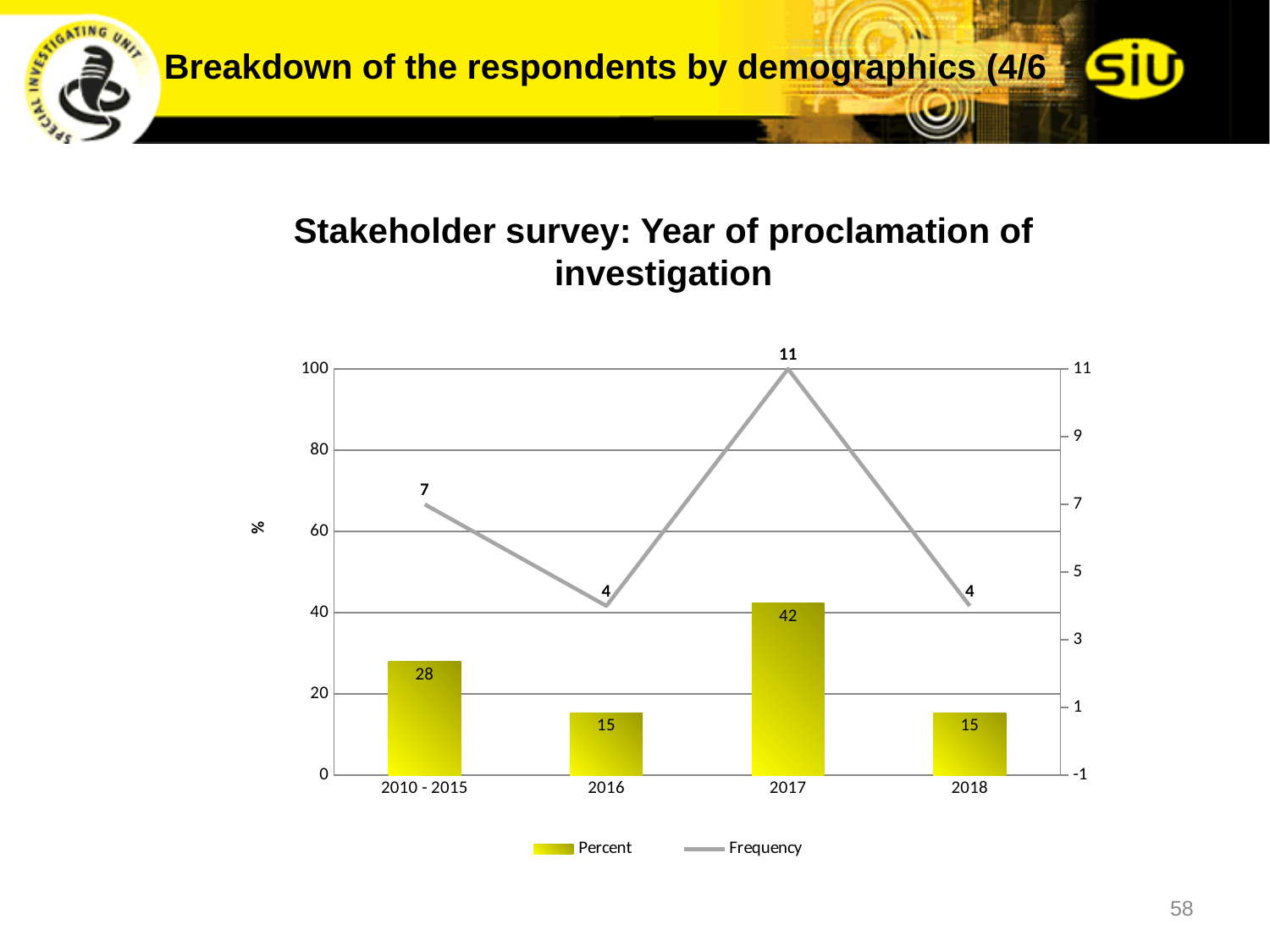
What is the difference between the Percent values for 2017 and 2010 - 2015? 14 What is the difference between the Frequency values for 2017 and 2018? 7 Which is larger, the Percent value for 2010 - 2015 or for 2018? 2010 - 2015 What is the Percent value for 2017? 42 How many series does the legend list? 2 What is the Frequency value for 2010 - 2015? 7 Which category has the highest Frequency? 2017 How many categories are shown on the x axis? 4 What is the Percent value for 2016? 15 What is the title of the chart? Stakeholder survey: Year of proclamation of investigation What kind of chart is used for the Percent series? Bar chart Which category has the highest Percent? 2017